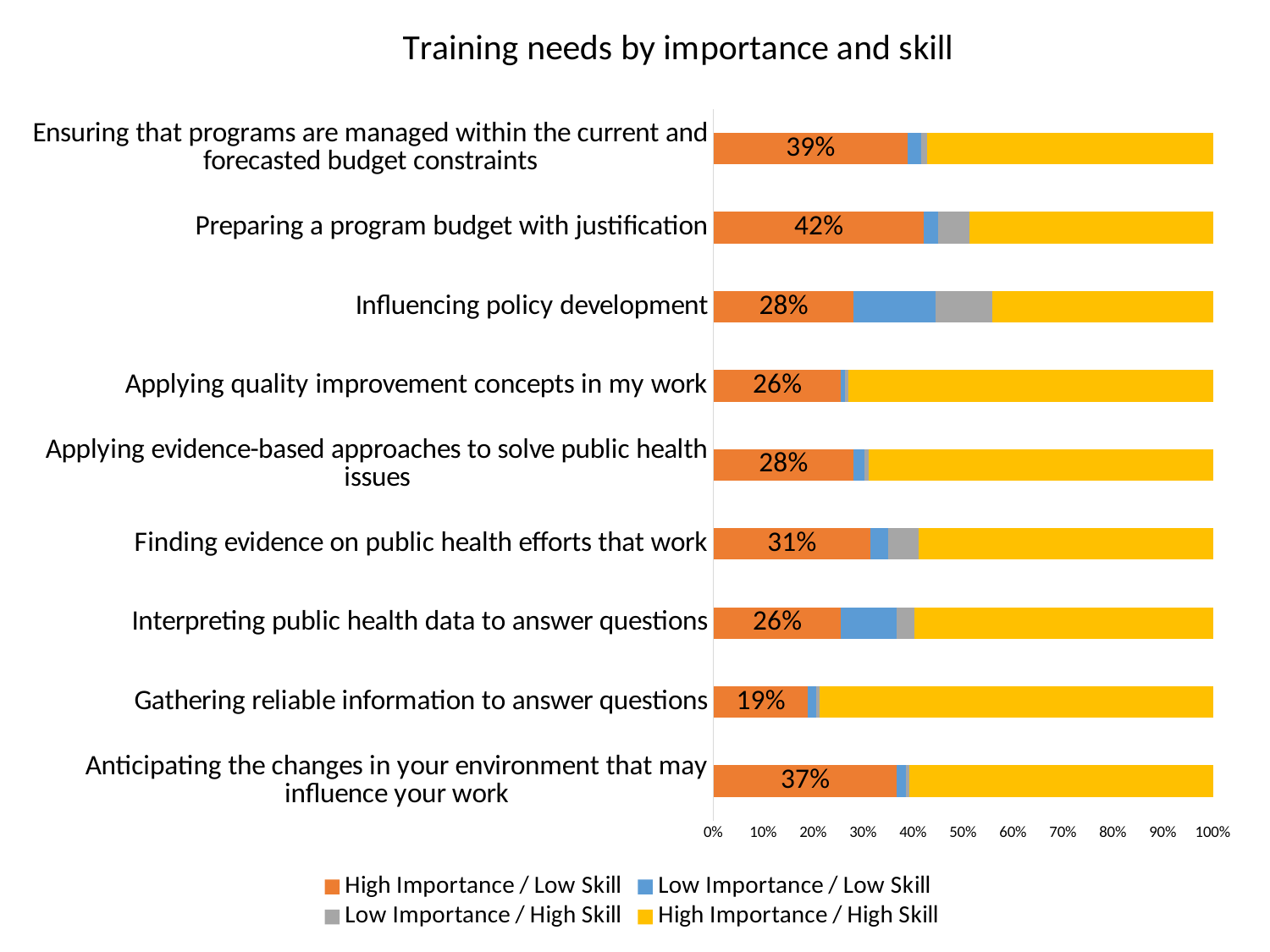
How many training need categories are plotted on the chart? 9 Which category has the highest High Importance / Low Skill value? Preparing a program budget with justification What is the High Importance / Low Skill value for 'Anticipating the changes in your environment that may influence your work'? 37% What is the difference between the High Importance / Low Skill values for 'Preparing a program budget with justification' and 'Gathering reliable information to answer questions'? 23 percentage points Which category has the lowest High Importance / Low Skill value? Gathering reliable information to answer questions What is the High Importance / Low Skill value for 'Preparing a program budget with justification'? 42% What is the title of the chart? Training needs by importance and skill Which has a larger High Importance / Low Skill value: 'Ensuring that programs are managed within the current and forecasted budget constraints' or 'Finding evidence on public health efforts that work'? Ensuring that programs are managed within the current and forecasted budget constraints How many series does the legend list? 4 What type of chart is shown on the slide? Stacked bar chart Is the Low Importance / Low Skill value for 'Influencing policy development' greater or less than 10%? greater What is the High Importance / Low Skill value for 'Gathering reliable information to answer questions'? 19%